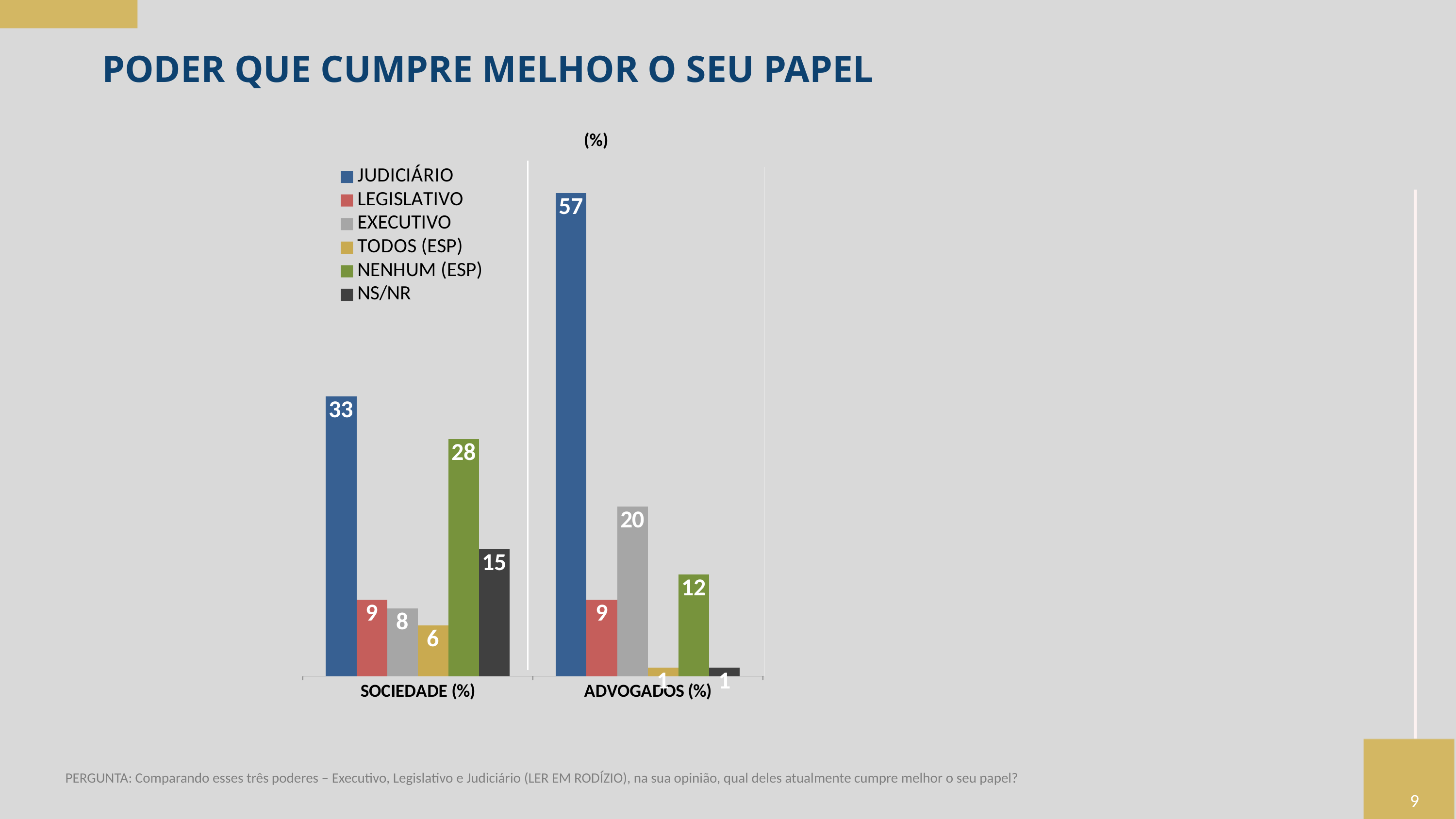
What is the value for JUDICIÁRIO in the ADVOGADOS (%) group? 57 Which is larger: NS/NR for SOCIEDADE (%) or NENHUM (ESP) for ADVOGADOS (%)? NS/NR for SOCIEDADE (%) What kind of chart is shown on the slide? Bar chart What is the value for JUDICIÁRIO in the SOCIEDADE (%) group? 33 What is the value for NENHUM (ESP) in the SOCIEDADE (%) group? 28 What is the value for TODOS (ESP) in the SOCIEDADE (%) group? 6 What colour represents NENHUM (ESP) in the chart? Green What is the difference between the JUDICIÁRIO values for ADVOGADOS (%) and SOCIEDADE (%)? 24 Which series has the highest value in the ADVOGADOS (%) group? JUDICIÁRIO How many series does the legend list? 6 Which series has the lowest value in the SOCIEDADE (%) group? TODOS (ESP) What is the value for EXECUTIVO in the ADVOGADOS (%) group? 20